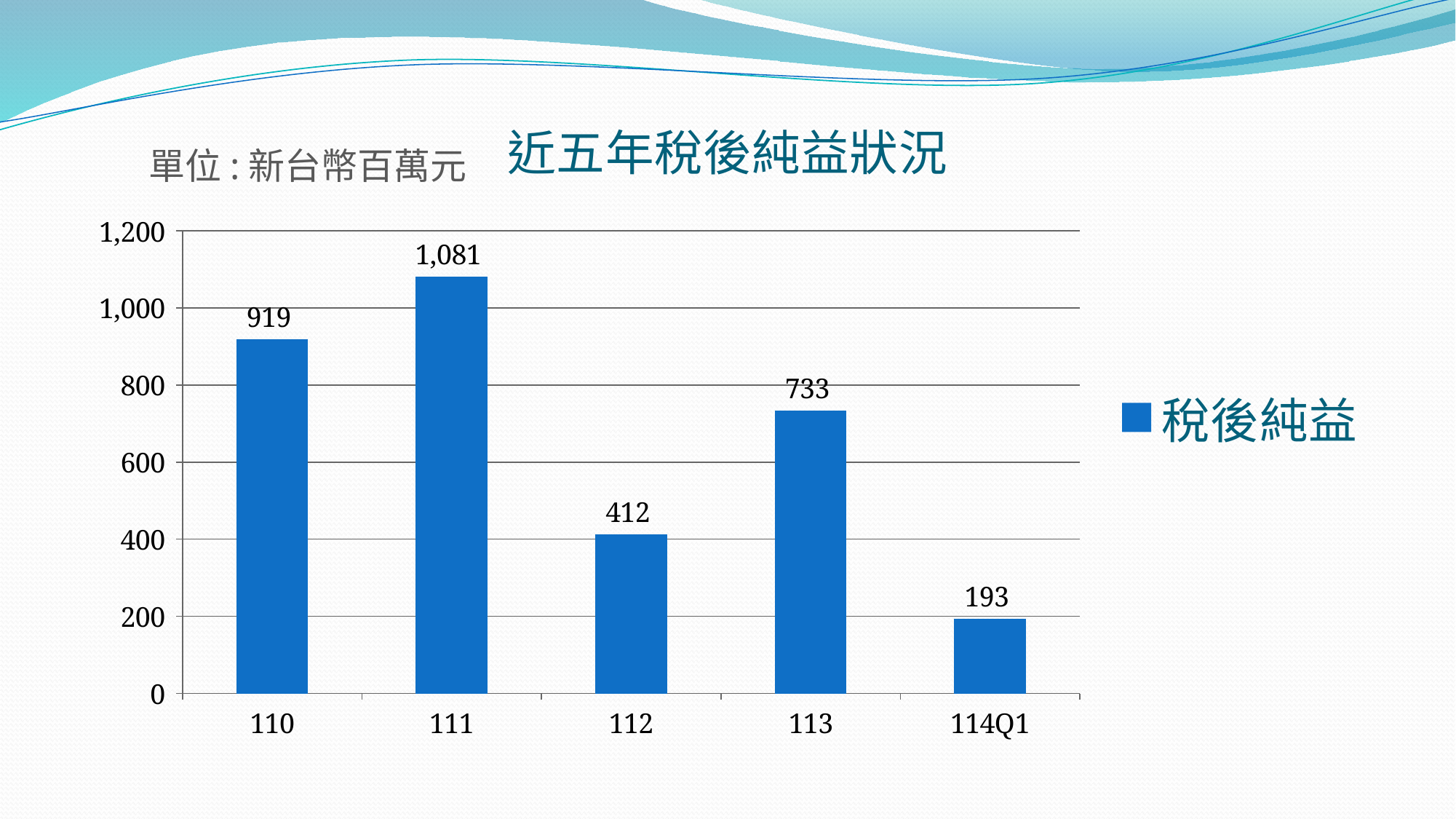
What is the value for 114Q1? 193 Which category has the lowest value? 114Q1 How many categories are shown on the x axis? 5 Is the value for 112 greater or less than 400? greater What is the difference between the values for 113 and 112? 321 What is the value for 111? 1,081 What is the difference between the values for 111 and 110? 162 What is the title of the chart? 近五年稅後純益狀況 Which category has the highest value? 111 What kind of chart is shown on the slide? bar chart What is the value for 110? 919 Which is larger, the value for 112 or the value for 113? 113